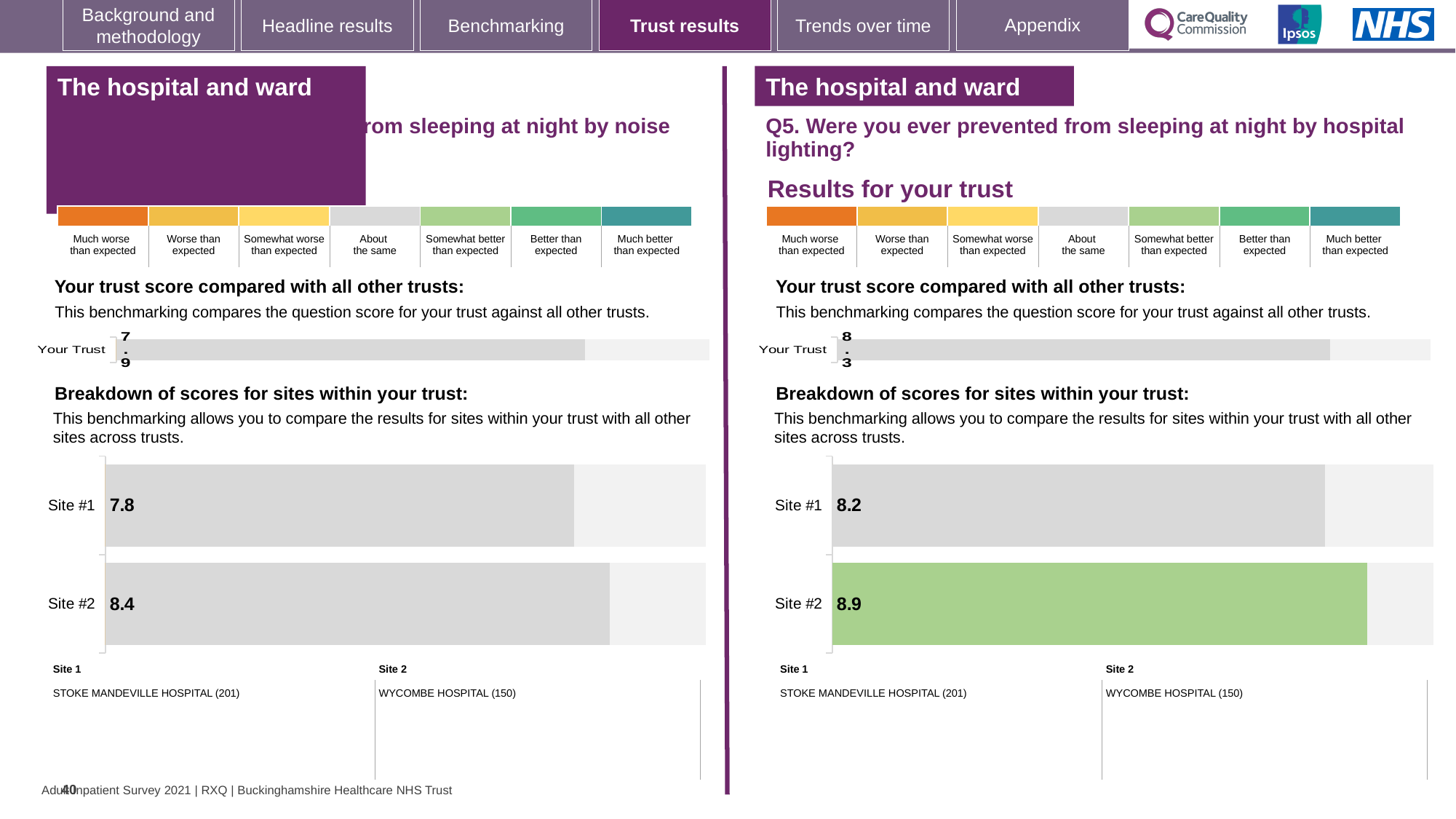
How many sites are shown in the right-hand site breakdown chart for Q5? 2 On the left-hand site breakdown chart, which site has the lower score? Site #1 On the right-hand chart for Q5 (hospital lighting), what is the score for Site #1? 8.2 On the right-hand chart for Q5 (hospital lighting), what is the score for Site #2? 8.9 What type of chart is used for the site breakdown on the right-hand side of the slide? Bar chart On the left-hand site breakdown chart (sleeping at night by noise), what is the score for Site #2? 8.4 On the left-hand site breakdown chart, what is the difference between the Site #2 and Site #1 scores? 0.6 On the left-hand 'Your trust score compared with all other trusts' chart, what is the score shown for Your Trust? 7.9 On the right-hand site breakdown chart for Q5, which site has the higher score? Site #2 On the right-hand site breakdown chart for Q5, what is the difference between the Site #2 and Site #1 scores? 0.7 On the right-hand 'Your trust score compared with all other trusts' chart for Q5, what is the score shown for Your Trust? 8.3 On the left-hand site breakdown chart (sleeping at night by noise), what is the score for Site #1? 7.8